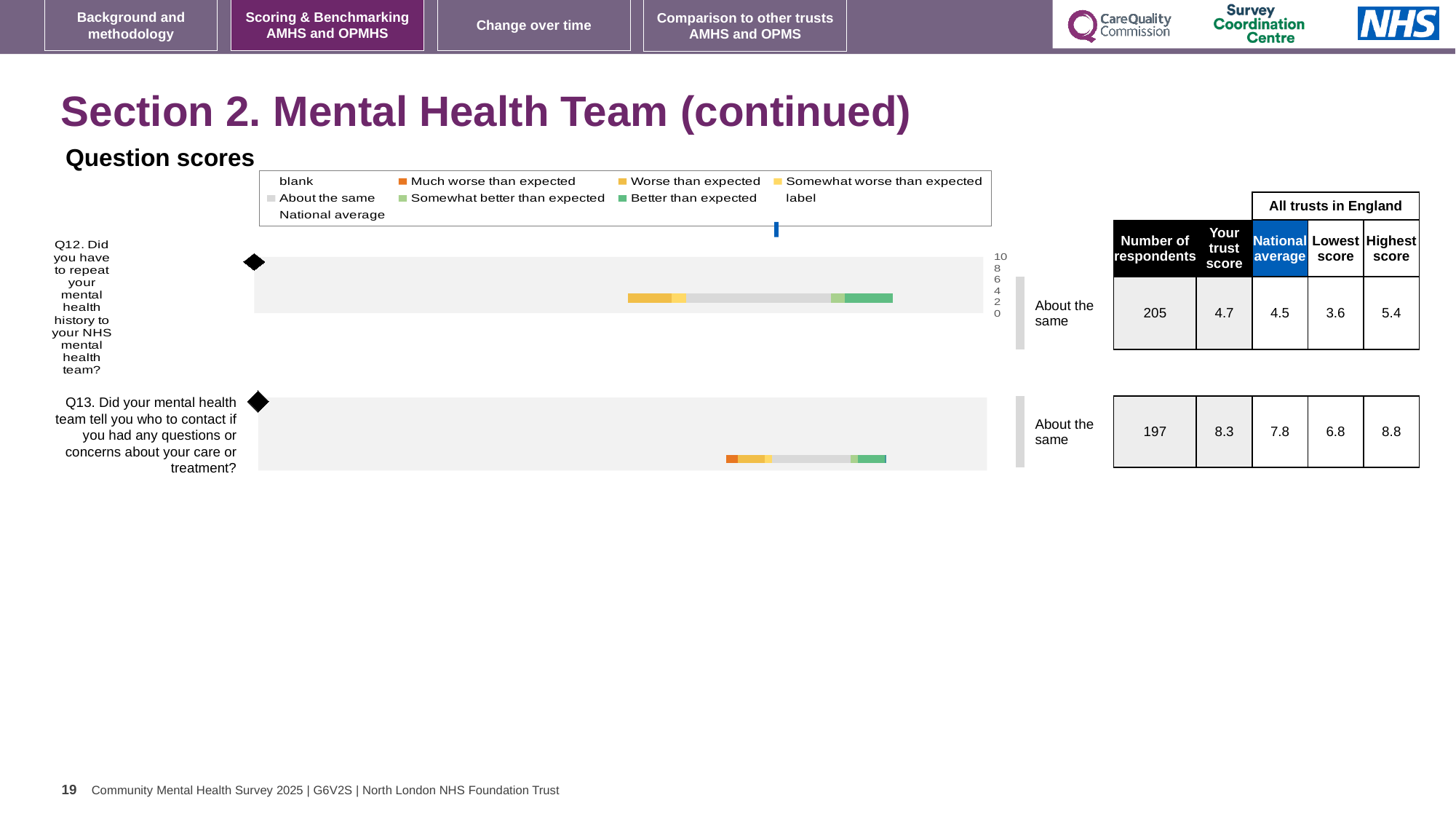
Which legend entry is shown in orange? Much worse than expected What kind of chart is used to show the question scores? Bar chart What is the 'Your trust score' shown for Q12 (Did you have to repeat your mental health history to your NHS mental health team?)? 4.7 Which question has the higher trust score, Q12 or Q13? Q13 What is the number of respondents shown for Q13? 197 What is the difference between the trust score and the national average for Q13? 0.5 What is the national average shown for Q12? 4.5 What is the lowest score among all trusts in England shown for Q13? 6.8 How many questions are plotted on the slide? 2 What is the 'Your trust score' shown for Q13 (Did your mental health team tell you who to contact if you had any questions or concerns about your care or treatment?)? 8.3 What is the highest score among all trusts in England shown for Q12? 5.4 What benchmark category label is shown next to the Q12 chart? About the same